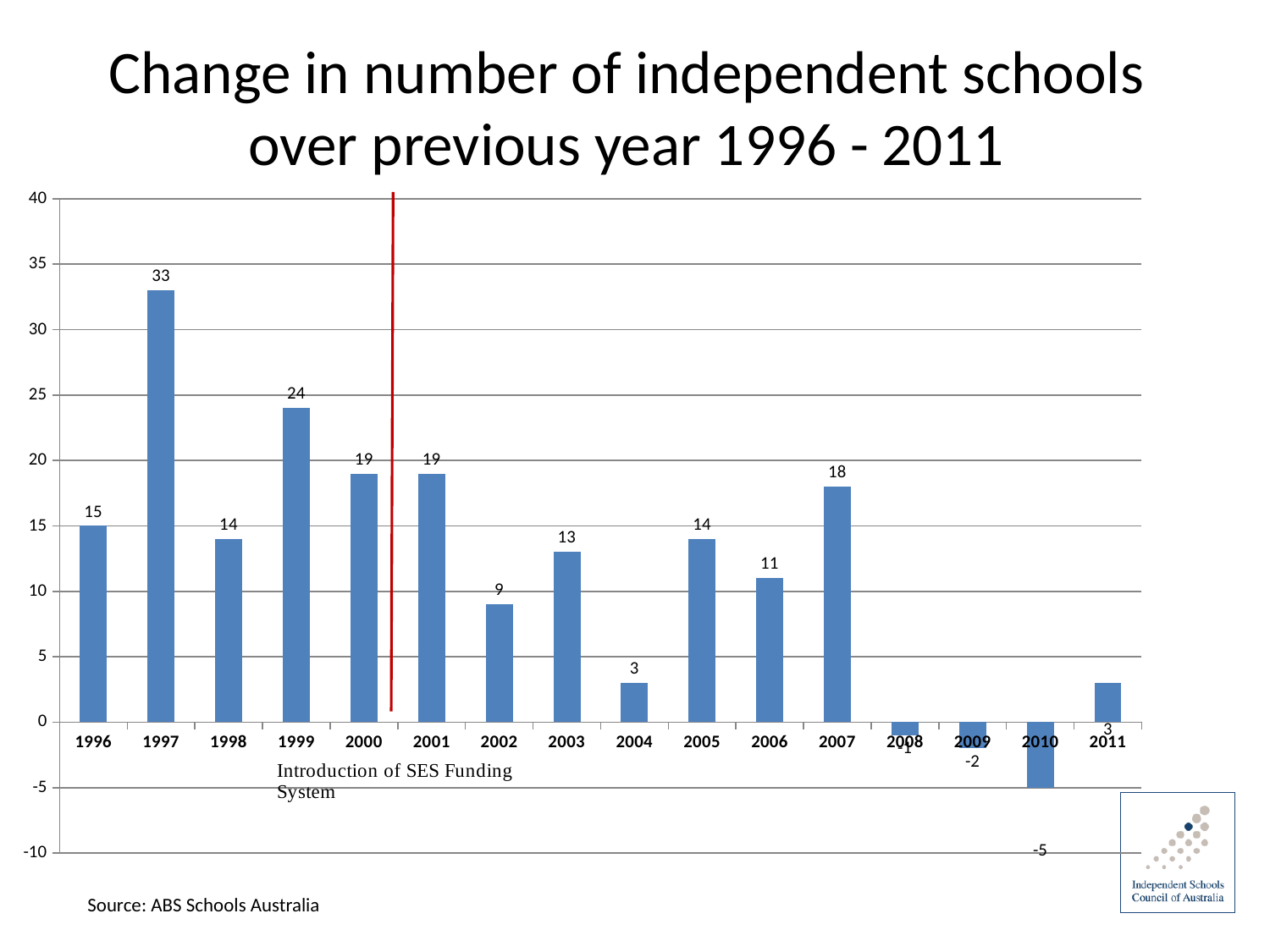
What event does the red vertical line on the chart mark? Introduction of SES Funding System What is the change in number of independent schools in 1997? 33 Which year has the highest change in number of independent schools? 1997 Is the value for 2007 greater or less than 15? greater What is the value shown for 1999? 24 How many years are shown on the x axis? 16 What is the value shown for 2004? 3 What type of chart is shown on the slide? bar chart What is the value shown for 2010? -5 Which year has the larger value, 2003 or 2006? 2003 What is the difference between the values for 1997 and 1999? 9 Which year has the lowest change in number of independent schools? 2010